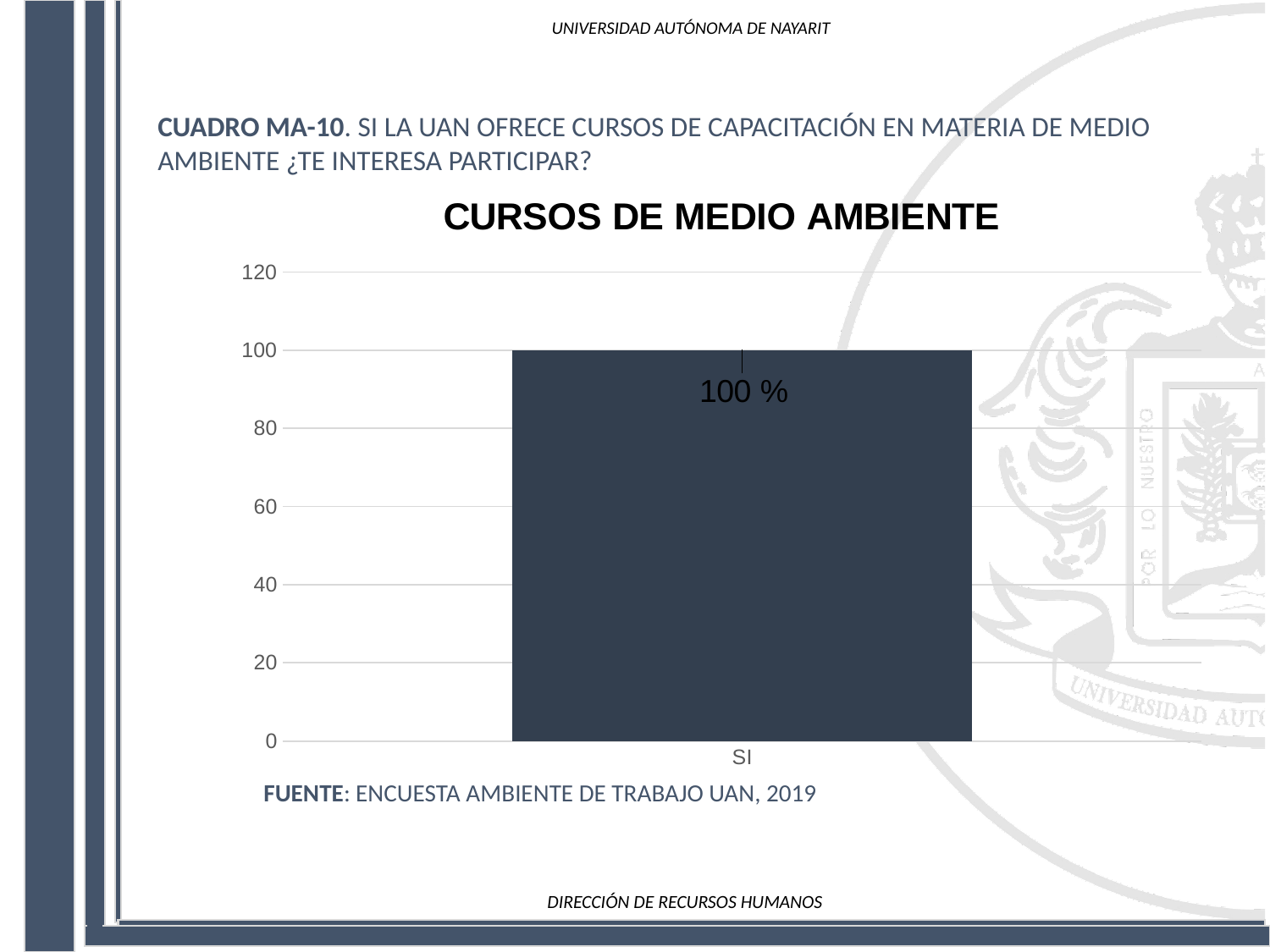
How many categories are plotted on the x axis? 1 What is the value shown for the SI bar? 100 % Is the value for SI greater or less than 80? greater What is the title of the chart? CURSOS DE MEDIO AMBIENTE What kind of chart is shown on the slide? bar chart What is the label of the only category on the x axis? SI What is the highest value shown on the vertical axis? 120